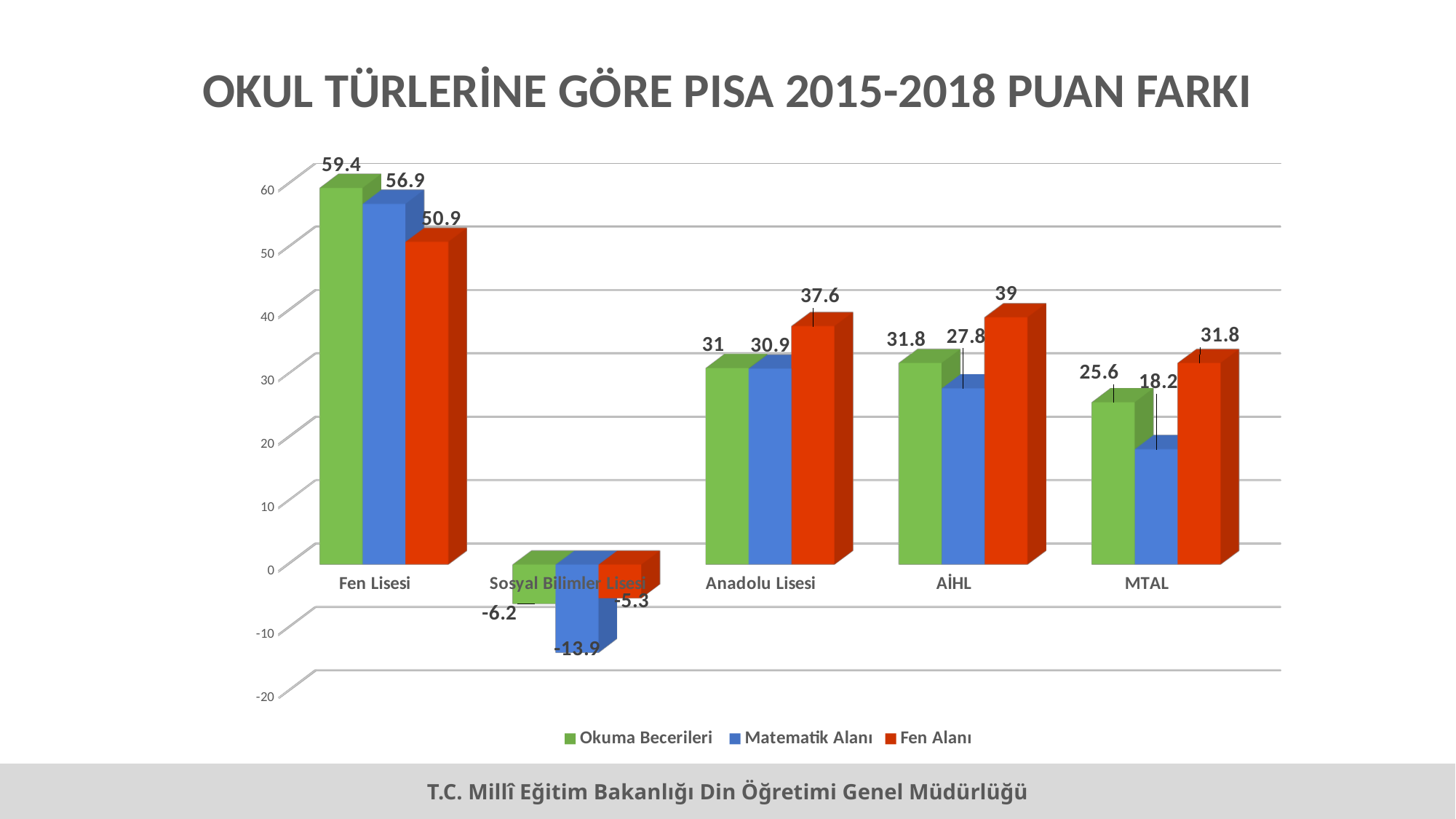
Which is larger for Anadolu Lisesi: the Fen Alanı value or the Okuma Becerileri value? Fen Alanı What is the Matematik Alanı value for MTAL? 18.2 What is the title of the chart? OKUL TÜRLERİNE GÖRE PISA 2015-2018 PUAN FARKI Which school type has the lowest Okuma Becerileri value? Sosyal Bilimler Lisesi What is the difference between the Okuma Becerileri and Matematik Alanı values for Fen Lisesi? 2.5 What is the Fen Alanı value for AİHL? 39 Which school type has the highest Fen Alanı value? Fen Lisesi How many school types are shown on the x axis? 5 What is the Okuma Becerileri value for Fen Lisesi? 59.4 What kind of chart is shown on the slide? Bar chart What is the Matematik Alanı value for Sosyal Bilimler Lisesi? -13.9 How many series does the legend list? 3